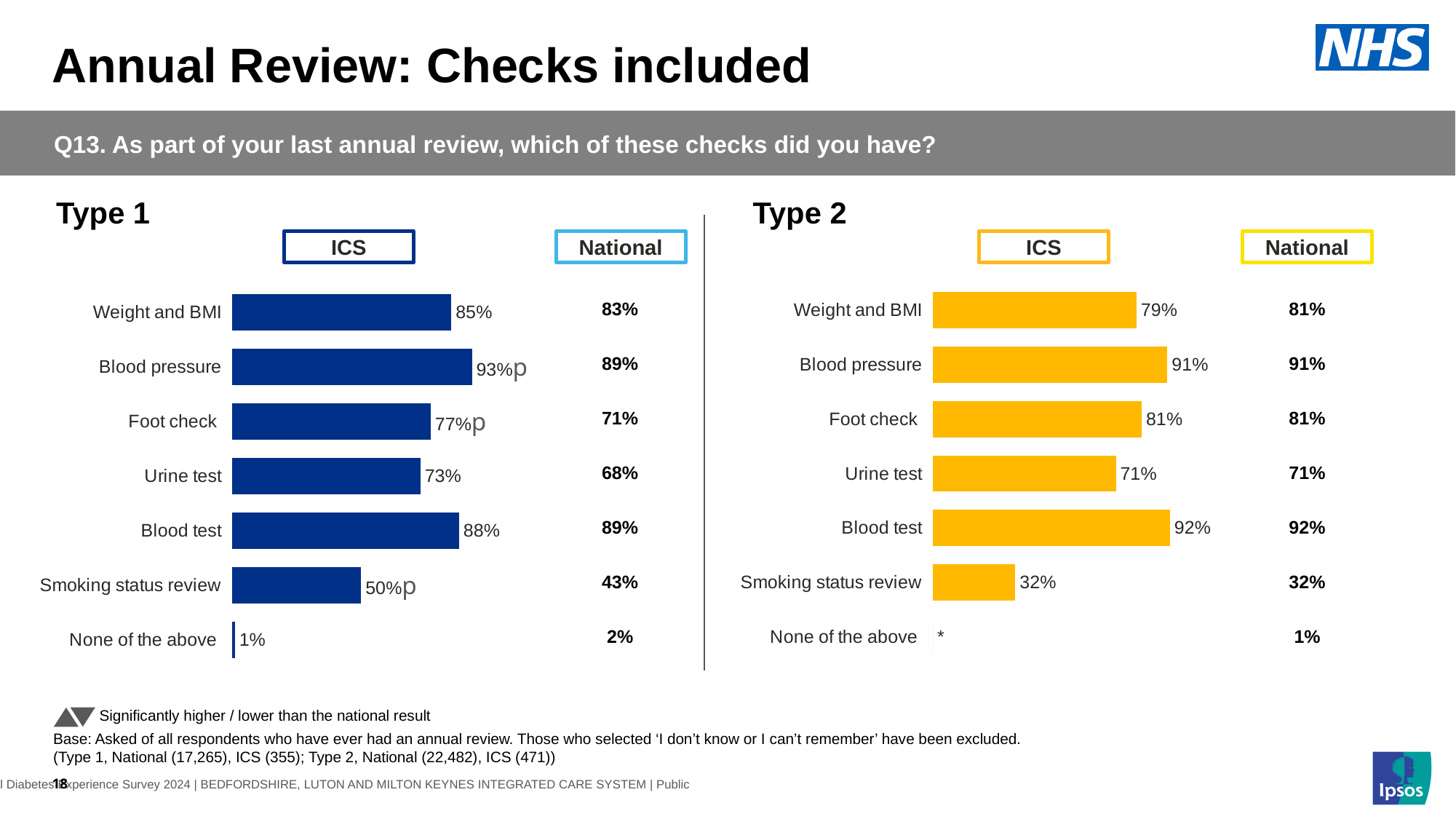
In the Type 2 chart, which check has the highest ICS value? Blood test In the Type 2 chart, what is the difference between the ICS values for Blood test and Weight and BMI? 13% In the Type 1 chart, which check has the lowest ICS value? None of the above In the Type 1 chart, what is the ICS value for Blood pressure? 93% What kind of chart is used for the Type 2 ICS results? Bar chart What colour are the ICS bars in the Type 2 chart? Yellow In the Type 1 chart, which is larger, the ICS value for Foot check or the ICS value for Urine test? Foot check In the Type 2 chart, what is the ICS value for Smoking status review? 32% How many checks are listed in the Type 1 chart? 7 In the Type 2 chart, which is larger, the ICS value for Blood pressure or the National value for Weight and BMI? ICS value for Blood pressure In the Type 1 chart, what is the National value for Urine test? 68% In the Type 1 chart, what is the difference between the ICS and National values for Smoking status review? 7%